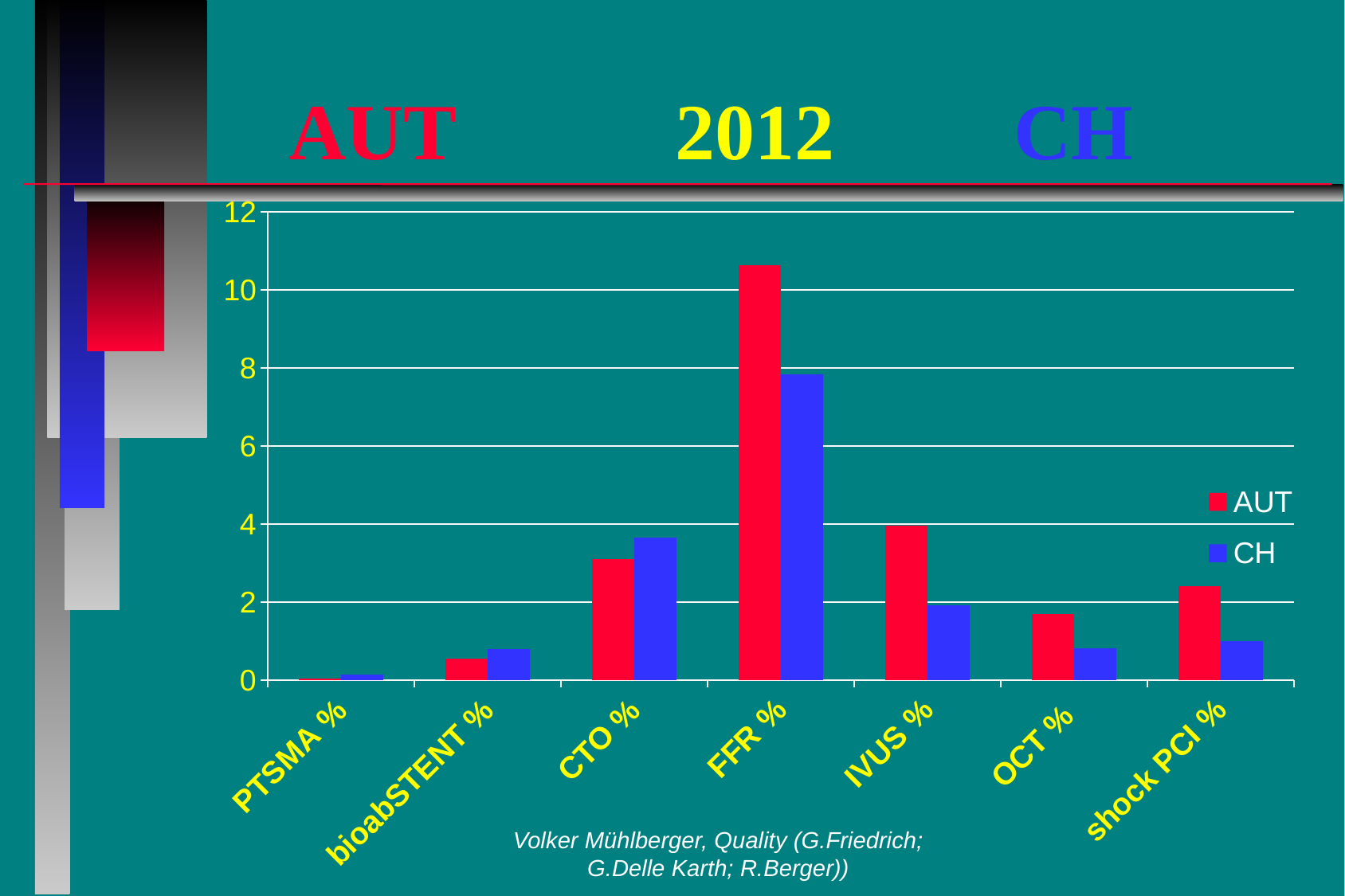
What colour are the bars for the CH series? blue Is the AUT value for FFR % greater or less than 10? greater How many series does the legend list? 2 Which category has the highest CH value? FFR % How many categories are shown on the x axis? 7 For CTO %, which series has the larger value, AUT or CH? CH What kind of chart is shown on the slide? bar chart For FFR %, which series has the larger value, AUT or CH? AUT Which category has the highest AUT value? FFR % Is the CH value for FFR % greater or less than 8? less Is the AUT value for OCT % greater or less than 2? less Which category has the lowest AUT value? PTSMA %